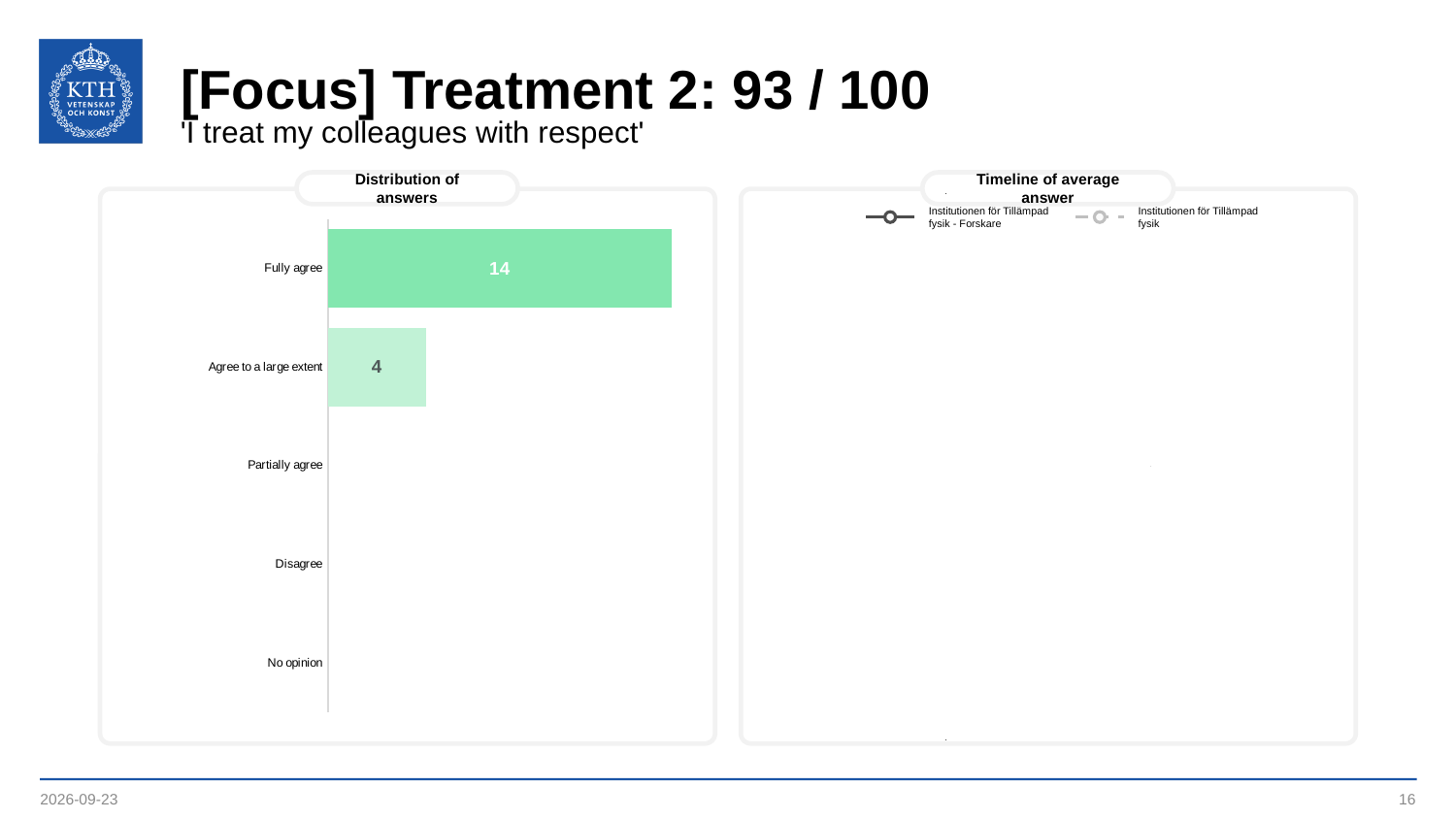
What is the first legend entry of the 'Timeline of average answer' chart? Institutionen för Tillämpad fysik - Forskare What kind of chart is the 'Distribution of answers' chart? Bar chart How many series does the legend of the 'Timeline of average answer' chart list? 2 In the 'Distribution of answers' chart, what is the value for 'Fully agree'? 14 What is the title of the chart on the left side of the slide? Distribution of answers In the 'Distribution of answers' chart, which category has the highest value? Fully agree How many answer categories are listed on the y axis of the 'Distribution of answers' chart? 5 In the 'Distribution of answers' chart, how many categories have a visible bar? 2 In the 'Distribution of answers' chart, what is the difference between the values for 'Fully agree' and 'Agree to a large extent'? 10 In the 'Distribution of answers' chart, what is the value for 'Agree to a large extent'? 4 In the 'Distribution of answers' chart, which is larger: the value for 'Fully agree' or the value for 'Agree to a large extent'? Fully agree